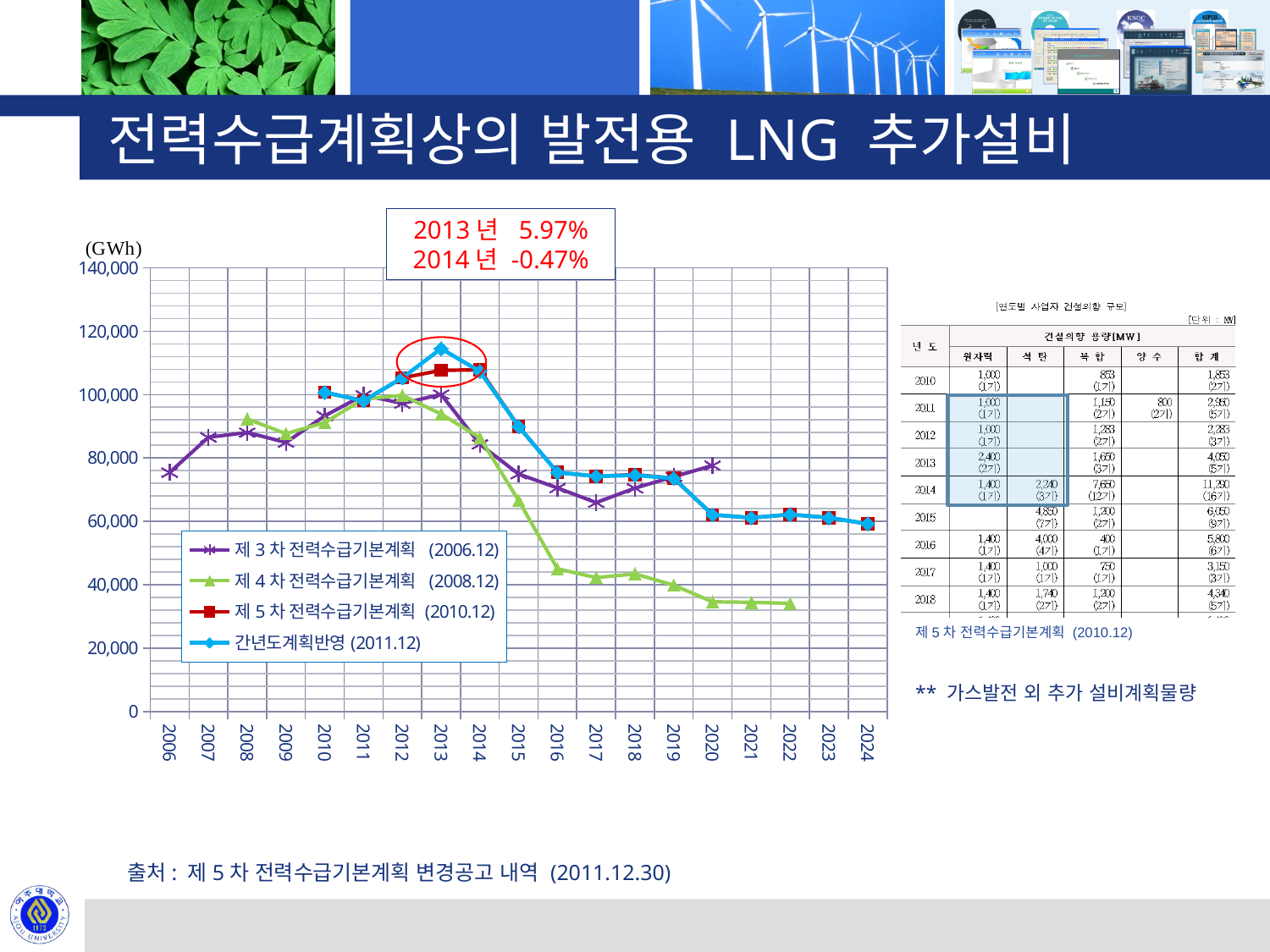
In which year does the 간년도계획반영 (2011.12) series reach its highest value? 2013 How many years are labelled along the x axis of the chart? 19 What unit is shown at the top of the y axis of the chart? GWh Is the value for 간년도계획반영 (2011.12) in 2013 greater or less than 100,000? greater Does the 제 4 차 전력수급기본계획 (2008.12) series rise or fall from 2014 to 2020? fall Is the value for 제 4 차 전력수급기본계획 (2008.12) in 2022 greater or less than 40,000? less How many series does the chart legend list? 4 Is the value for 제 5 차 전력수급기본계획 (2010.12) in 2015 greater or less than 80,000? greater What kind of chart is shown on the slide? line chart What percentage is annotated for 2013 in the box above the chart? 5.97% In 2020, which series has the larger value: 제 3 차 전력수급기본계획 (2006.12) or 제 4 차 전력수급기본계획 (2008.12)? 제 3 차 전력수급기본계획 (2006.12)